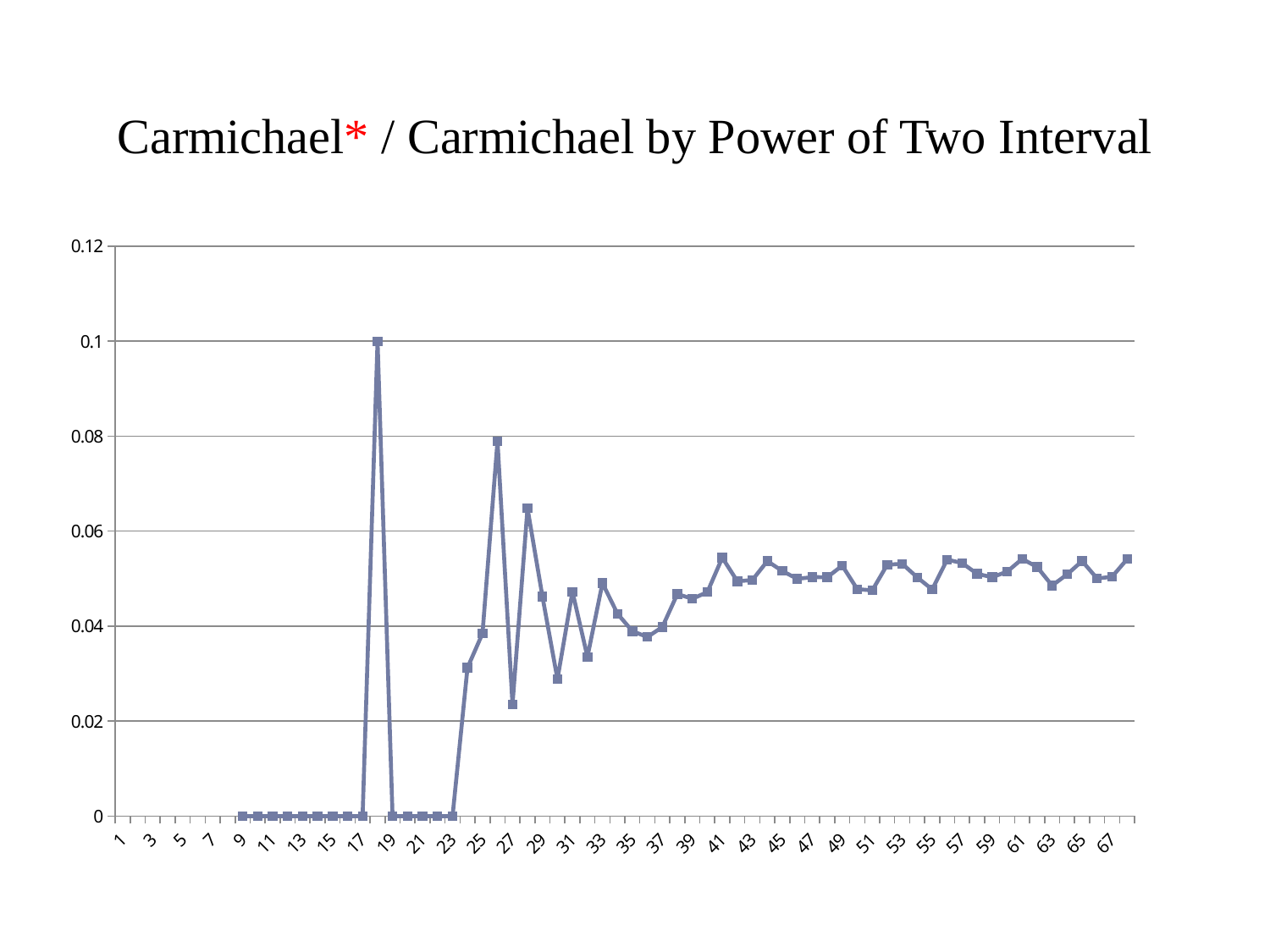
Is the value at x = 29 greater or less than 0.04? greater Is the value at x = 41 greater or less than 0.06? less What is the value plotted at x = 9? 0 Is the peak value on the chart greater or less than 0.08? greater What is the highest tick label on the y axis? 0.12 What is the value plotted at x = 21? 0 What kind of chart is shown on the slide? line chart What is the highest value plotted on the chart? 0.1 What is the title of the chart? Carmichael* / Carmichael by Power of Two Interval Do the values rise or fall between x = 23 and x = 25? rise Which is larger, the value at x = 25 or the value at x = 27? x = 25